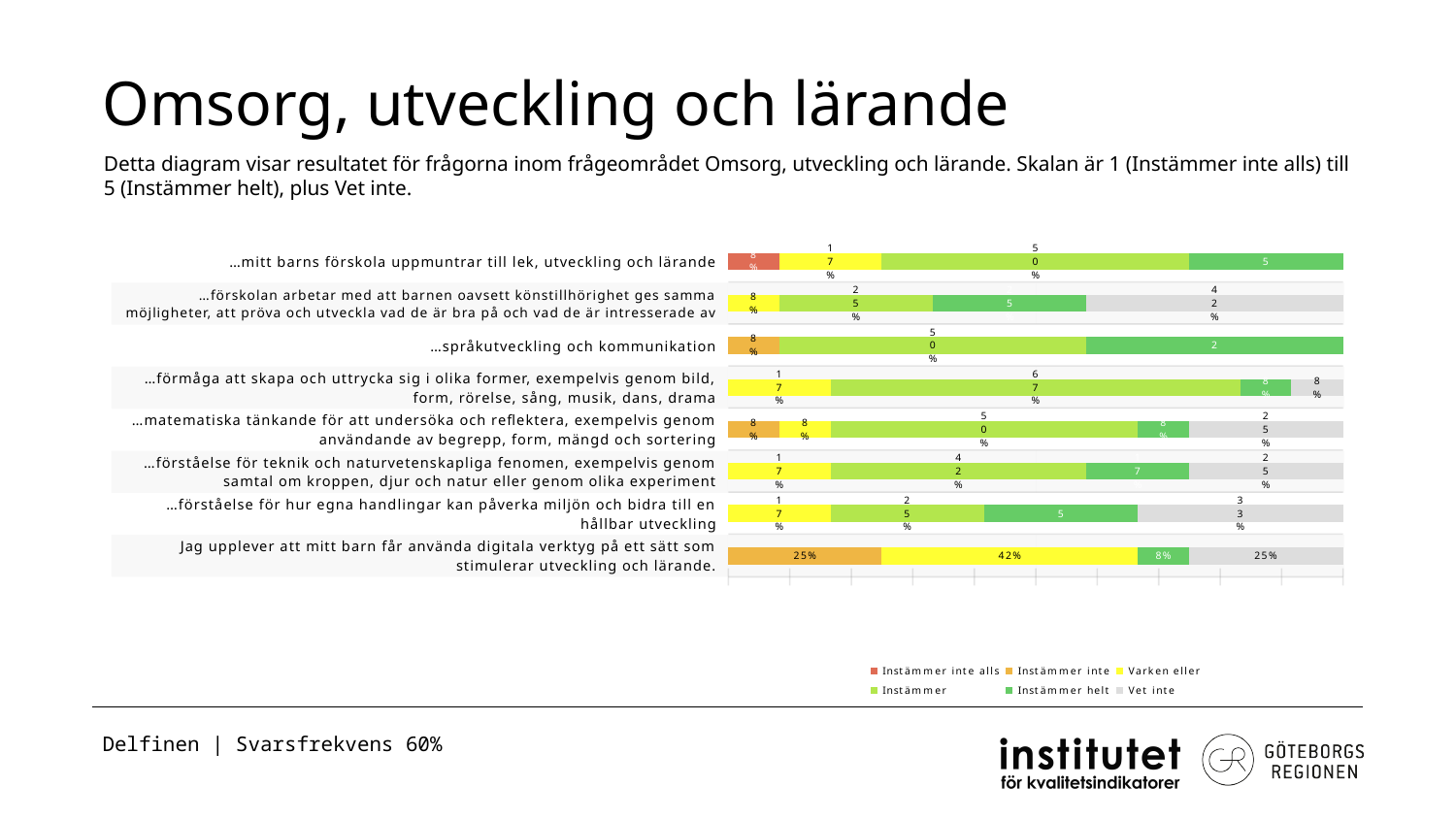
For the statement about digital tools ('Jag upplever att mitt barn får använda digitala verktyg…'), which is larger: the 'Varken eller' share or the 'Instämmer inte' share? Varken eller What is the 'Varken eller' share for the statement 'Jag upplever att mitt barn får använda digitala verktyg på ett sätt som stimulerar utveckling och lärande.'? 42% How many series does the chart legend list? 6 What is the 'Instämmer' share for the statement '…mitt barns förskola uppmuntrar till lek, utveckling och lärande'? 50% For the statement about digital tools ('Jag upplever att mitt barn får använda digitala verktyg…'), what is the difference between the 'Varken eller' share and the 'Instämmer inte' share? 17 percentage points What is the 'Instämmer helt' share for the statement '…språkutveckling och kommunikation'? 42% What type of chart is shown on the slide? Stacked bar chart What is the 'Vet inte' share for the statement '…förskolan arbetar med att barnen oavsett könstillhörighet ges samma möjligheter…'? 42% How many statements (categories) are plotted in the chart? 8 What is the 'Vet inte' share for the statement 'Jag upplever att mitt barn får använda digitala verktyg på ett sätt som stimulerar utveckling och lärande.'? 25% Which statement has the largest 'Instämmer' share? …förmåga att skapa och uttrycka sig i olika former, exempelvis genom bild, form, rörelse, sång, musik, dans, drama What colour represents 'Vet inte' in the chart legend? Grey